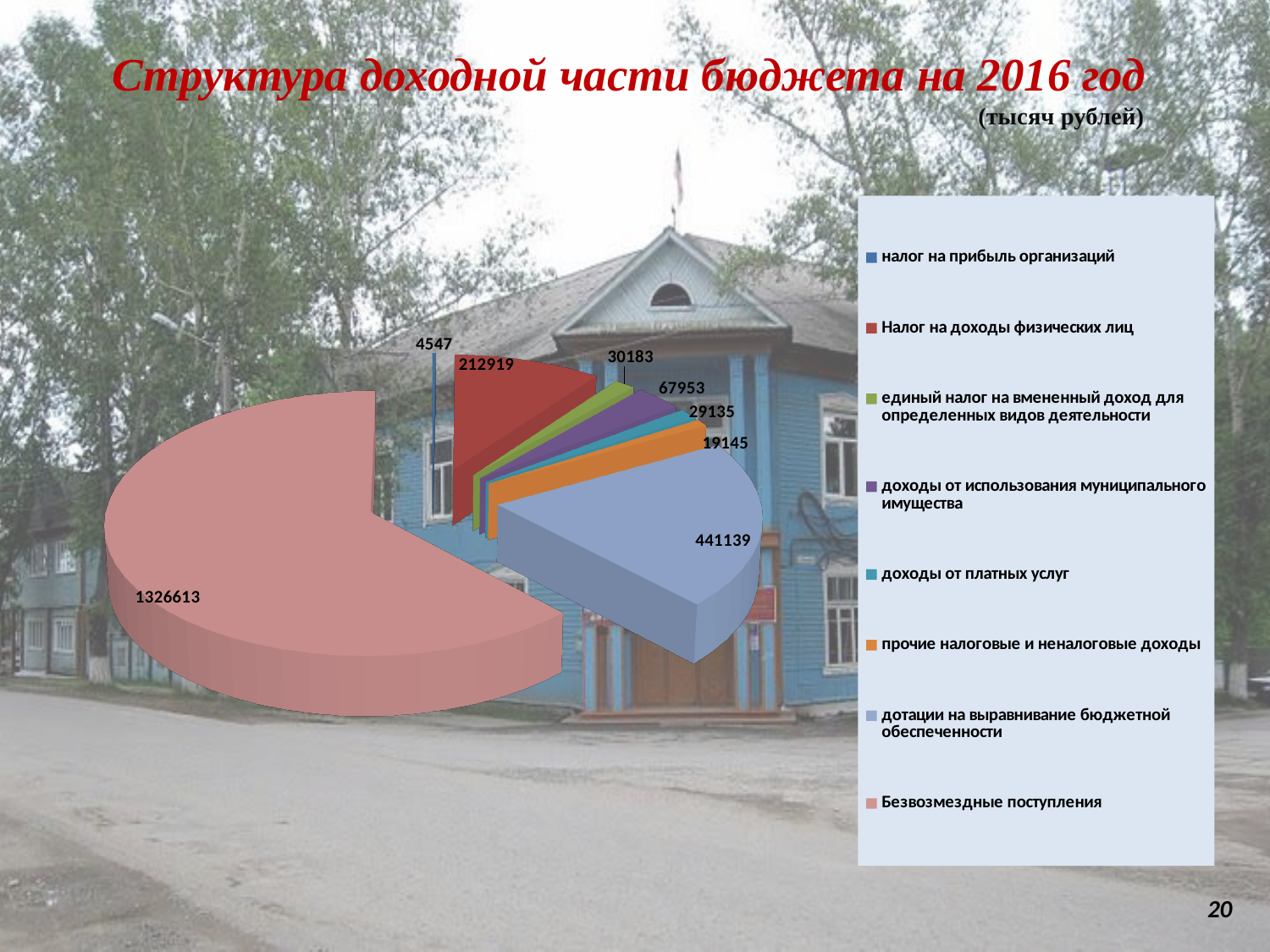
What is the value for налог на прибыль организаций? 4547 What is the value for Безвозмездные поступления? 1326613 What is the value for доходы от использования муниципального имущества? 67953 What kind of chart is shown on the slide? pie chart What is the value for дотации на выравнивание бюджетной обеспеченности? 441139 Which category has the largest slice of the pie? Безвозмездные поступления How many categories does the legend of the pie chart list? 8 What is the difference between the values for Безвозмездные поступления and дотации на выравнивание бюджетной обеспеченности? 885474 Which category has the smallest slice of the pie? налог на прибыль организаций What is the value for Налог на доходы физических лиц? 212919 What unit is stated under the chart title? тысяч рублей Which is larger: the value for доходы от платных услуг or the value for прочие налоговые и неналоговые доходы? доходы от платных услуг